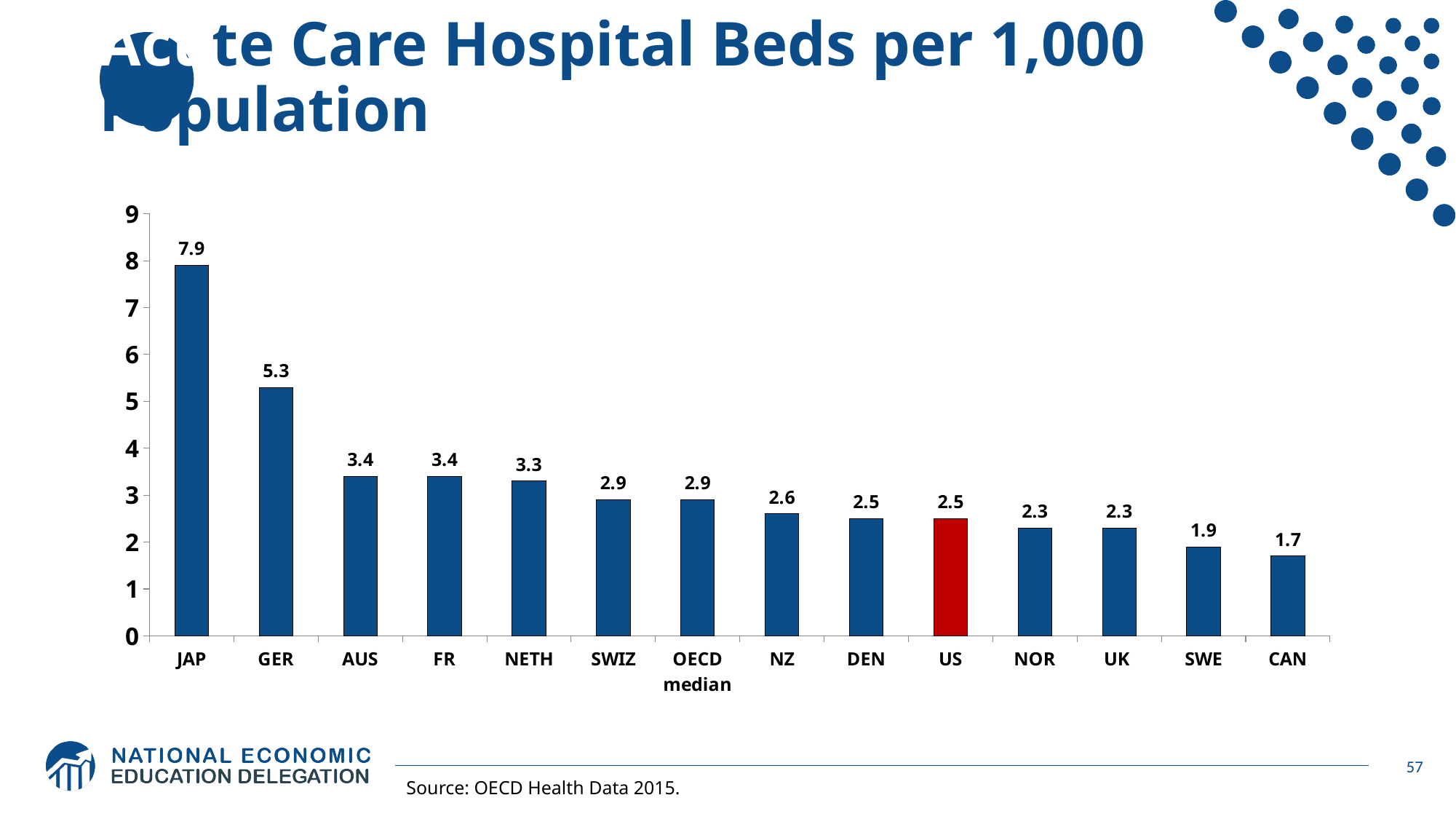
What is the value for the OECD median? 2.9 What is the value for JAP? 7.9 Which is larger, the value for NETH or the value for SWIZ? NETH Which country has the lowest number of acute care hospital beds per 1,000 population? CAN How many bars are shown in the chart? 14 Is the value for GER greater or less than 5? greater What is the value for the US? 2.5 What is the difference between the OECD median and the US value? 0.4 What kind of chart is shown on the slide? Bar chart What is the difference between the values for JAP and GER? 2.6 Which country has the highest number of acute care hospital beds per 1,000 population? JAP Which bar is coloured red rather than blue? US